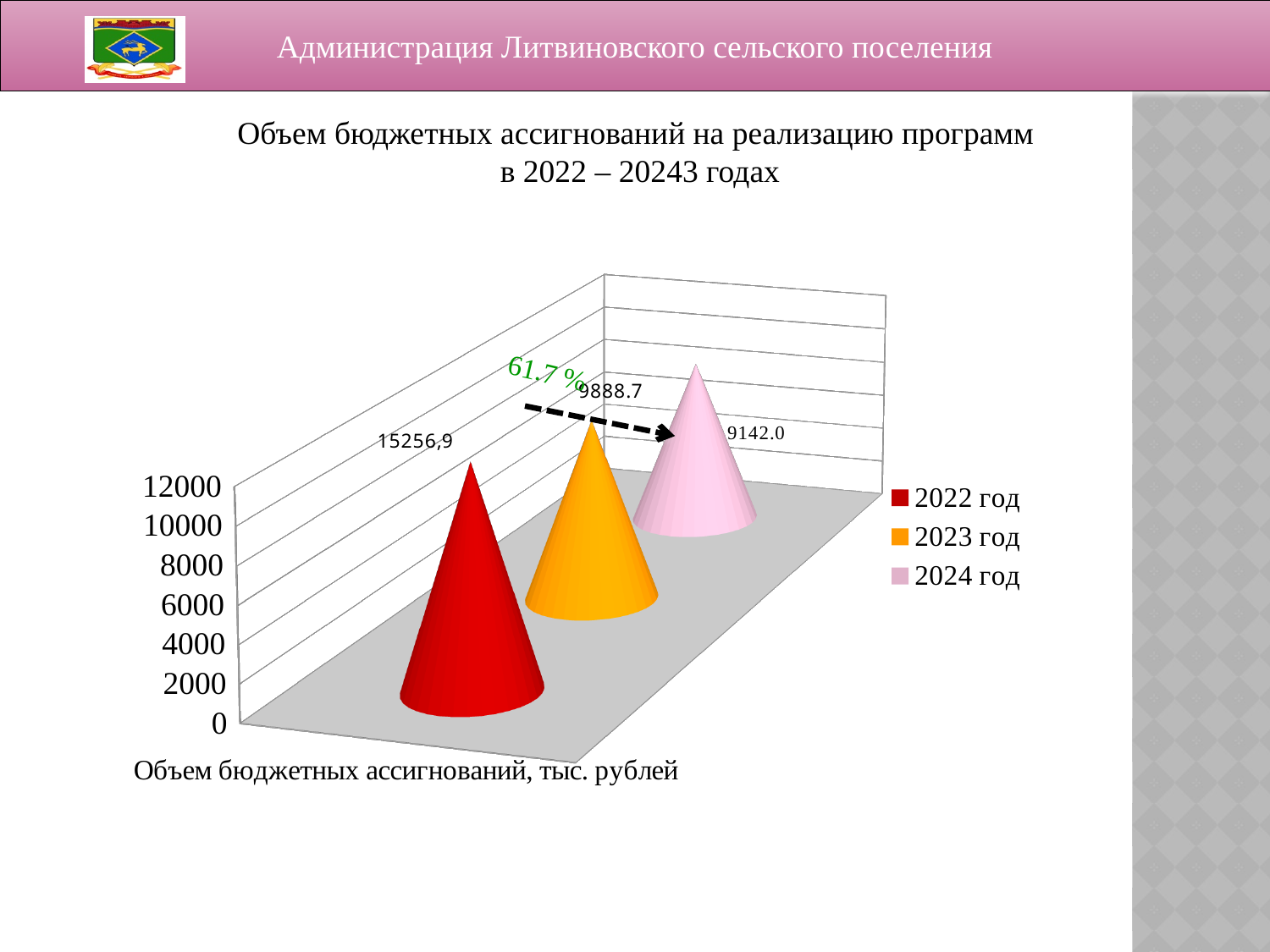
What is the value shown for 2022 год? 15256,9 What percentage is written next to the arrow on the chart? 61,7 % Which year has the lowest value? 2024 год What is the difference between the values for 2023 год and 2024 год? 746.7 Do the values rise or fall from 2022 год to 2024 год? fall How many series does the legend list? 3 Which is larger, the value for 2022 год or the value for 2023 год? 2022 год What is the value shown for 2023 год? 9888.7 Is the value for 2024 год greater or less than 10000? less Which year has the highest value? 2022 год What is the value shown for 2024 год? 9142.0 What kind of chart is shown on the slide? bar chart